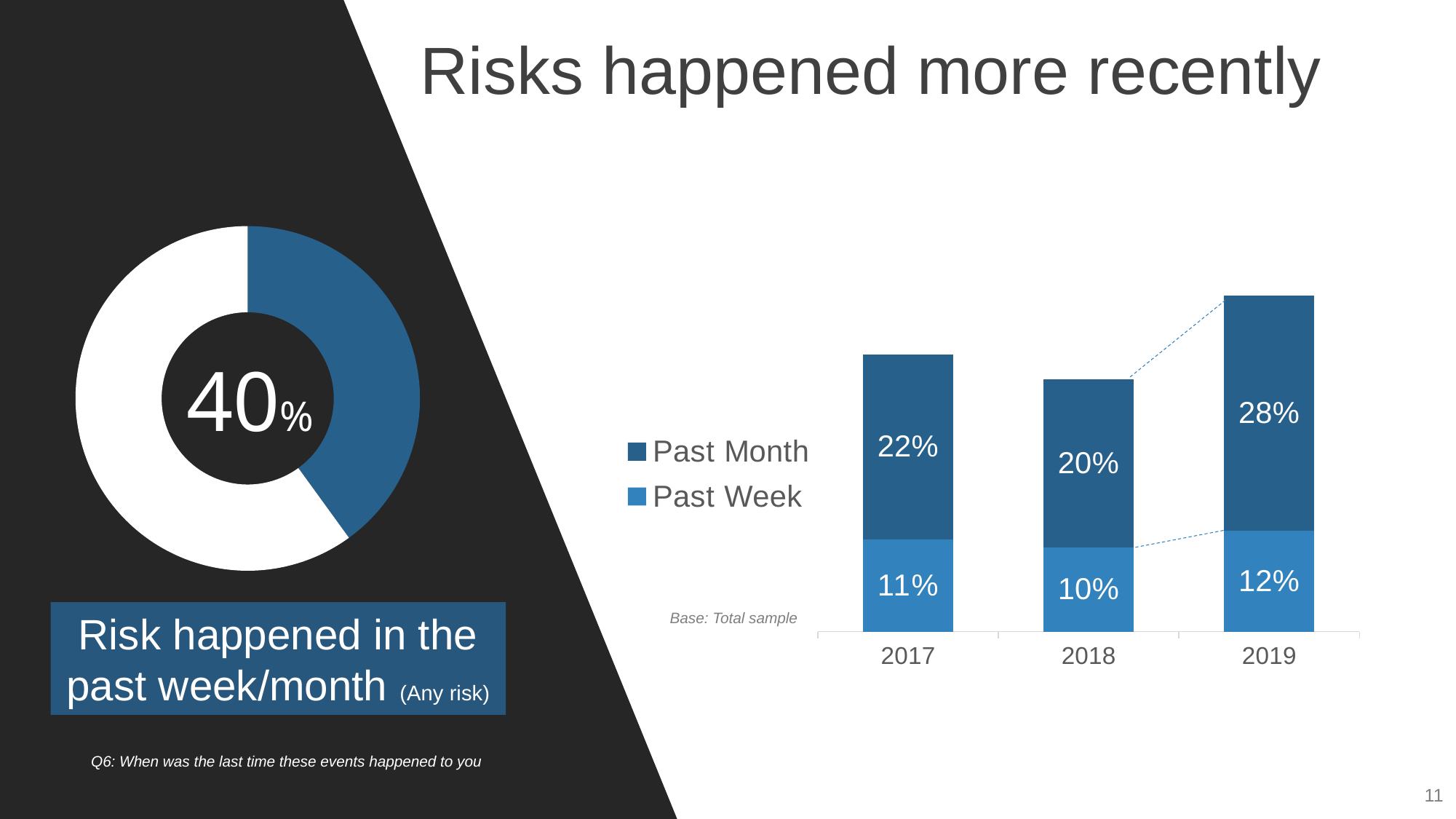
What percentage is shown in the centre of the donut chart on the left? 40% In the stacked bar chart on the right, what is the Past Month value for 2019? 28% In the stacked bar chart on the right, what is the difference between the Past Month values for 2019 and 2018? 8% In the stacked bar chart on the right, which year has the highest Past Month value? 2019 In the stacked bar chart on the right, what is the total of the 2019 bar (Past Week plus Past Month)? 40% In the stacked bar chart on the right, what is the Past Month value for 2017? 22% In the stacked bar chart on the right, is the Past Week value for 2017 larger or smaller than the Past Week value for 2019? smaller In the stacked bar chart on the right, what is the Past Week value for 2018? 10% In the stacked bar chart on the right, which year has the lowest Past Week value? 2018 How many series does the legend of the stacked bar chart on the right list? 2 How many years are shown on the x axis of the stacked bar chart on the right? 3 What kind of chart is shown on the right side of the slide? Stacked bar chart